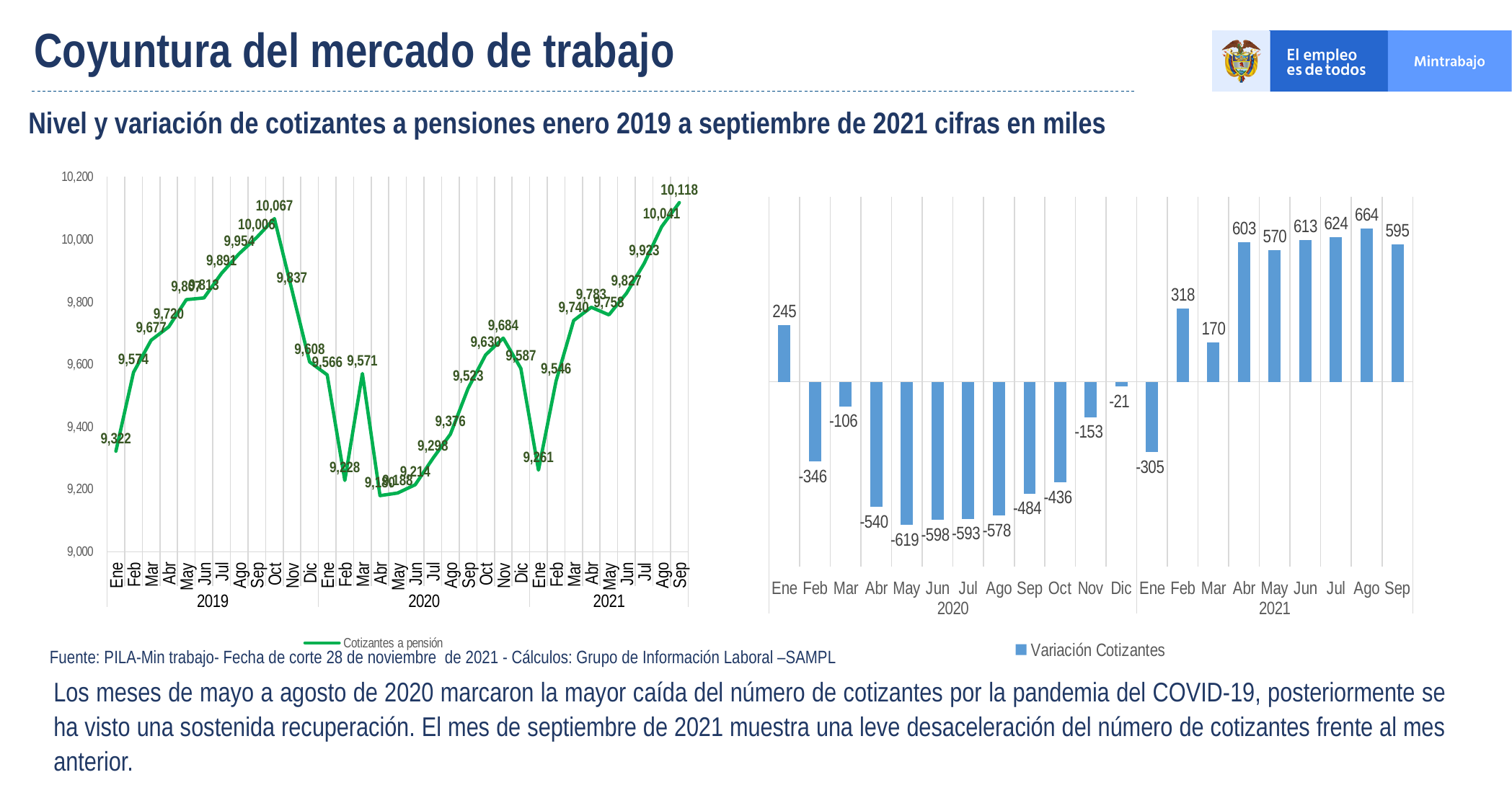
In the left chart (Cotizantes a pensión), what is the difference between the values for September 2021 and August 2021? 77 In the left chart (Cotizantes a pensión), what is the value for October 2019? 10,067 What kind of chart is the right chart (Variación Cotizantes)? Bar chart In the right chart (Variación Cotizantes), what is the value for May 2020? -619 In the right chart (Variación Cotizantes), which month has the lowest value? May 2020 What is the legend entry of the left chart? Cotizantes a pensión In the left chart (Cotizantes a pensión), what is the value for January 2019? 9,322 In the right chart (Variación Cotizantes), which is larger, the value for February 2021 or the value for March 2021? February 2021 In the left chart (Cotizantes a pensión), what is the value for September 2021? 10,118 In the left chart (Cotizantes a pensión), which month has the highest value? Sep 2021 In the right chart (Variación Cotizantes), what is the difference between the values for August 2021 and September 2021? 69 In the right chart (Variación Cotizantes), which month has the highest value? Ago 2021